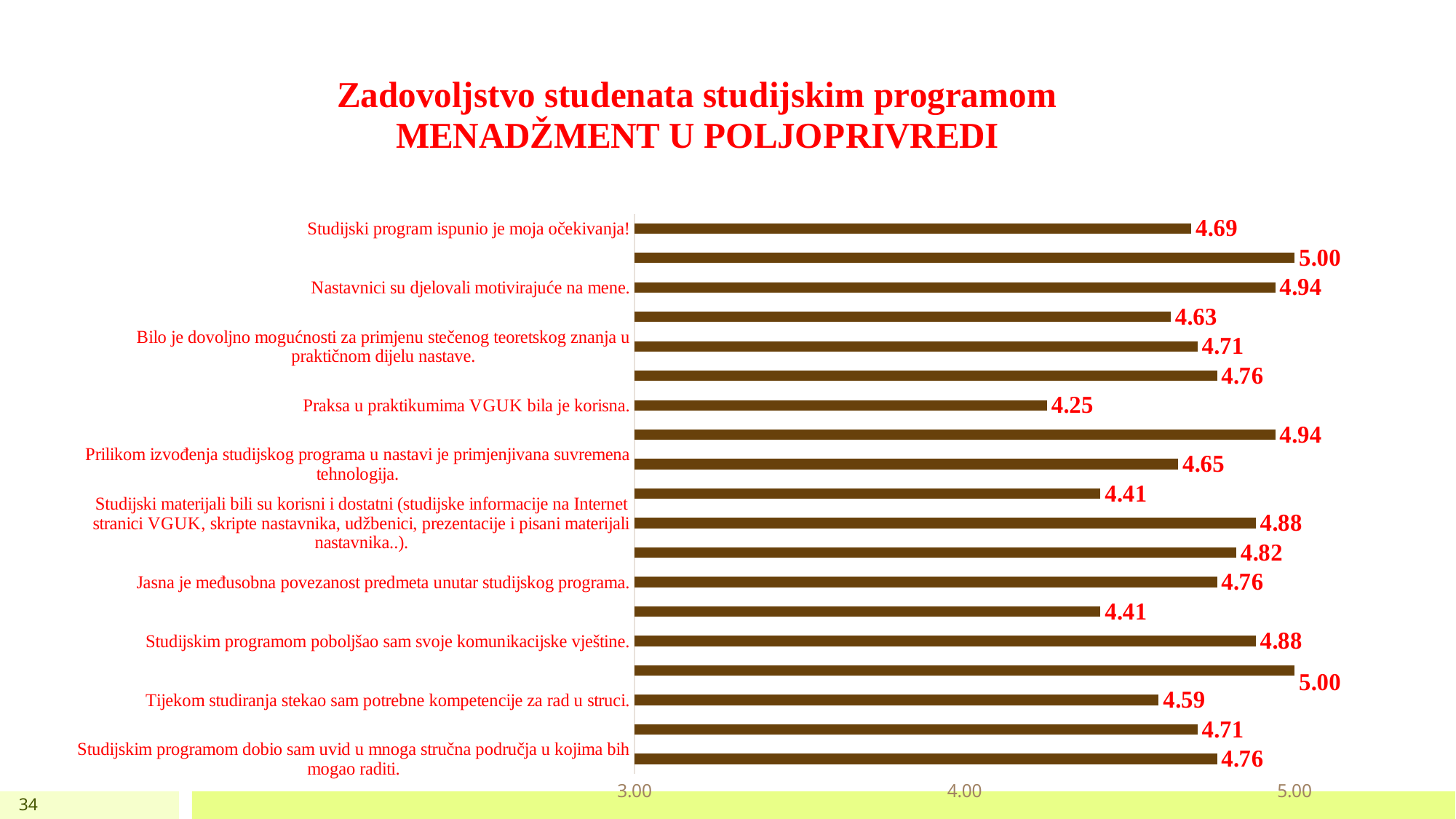
What is the value for "Studijski program ispunio je moja očekivanja!"? 4.69 Which labelled statement has the lowest value? Praksa u praktikumima VGUK bila je korisna. What kind of chart is shown on the slide? bar chart How many bars are plotted on the chart? 19 What is the value for "Tijekom studiranja stekao sam potrebne kompetencije za rad u struci."? 4.59 Which is larger: the value for "Jasna je međusobna povezanost predmeta unutar studijskog programa." or for "Tijekom studiranja stekao sam potrebne kompetencije za rad u struci."? Jasna je međusobna povezanost predmeta unutar studijskog programa. What is the value for "Praksa u praktikumima VGUK bila je korisna."? 4.25 What is the value for "Studijskim programom poboljšao sam svoje komunikacijske vještine."? 4.88 What is the highest value shown on the chart? 5.00 What is the value for "Nastavnici su djelovali motivirajuće na mene."? 4.94 What is the difference between the values for "Nastavnici su djelovali motivirajuće na mene." and "Praksa u praktikumima VGUK bila je korisna."? 0.69 Is the value for "Praksa u praktikumima VGUK bila je korisna." greater or less than 4.00? greater